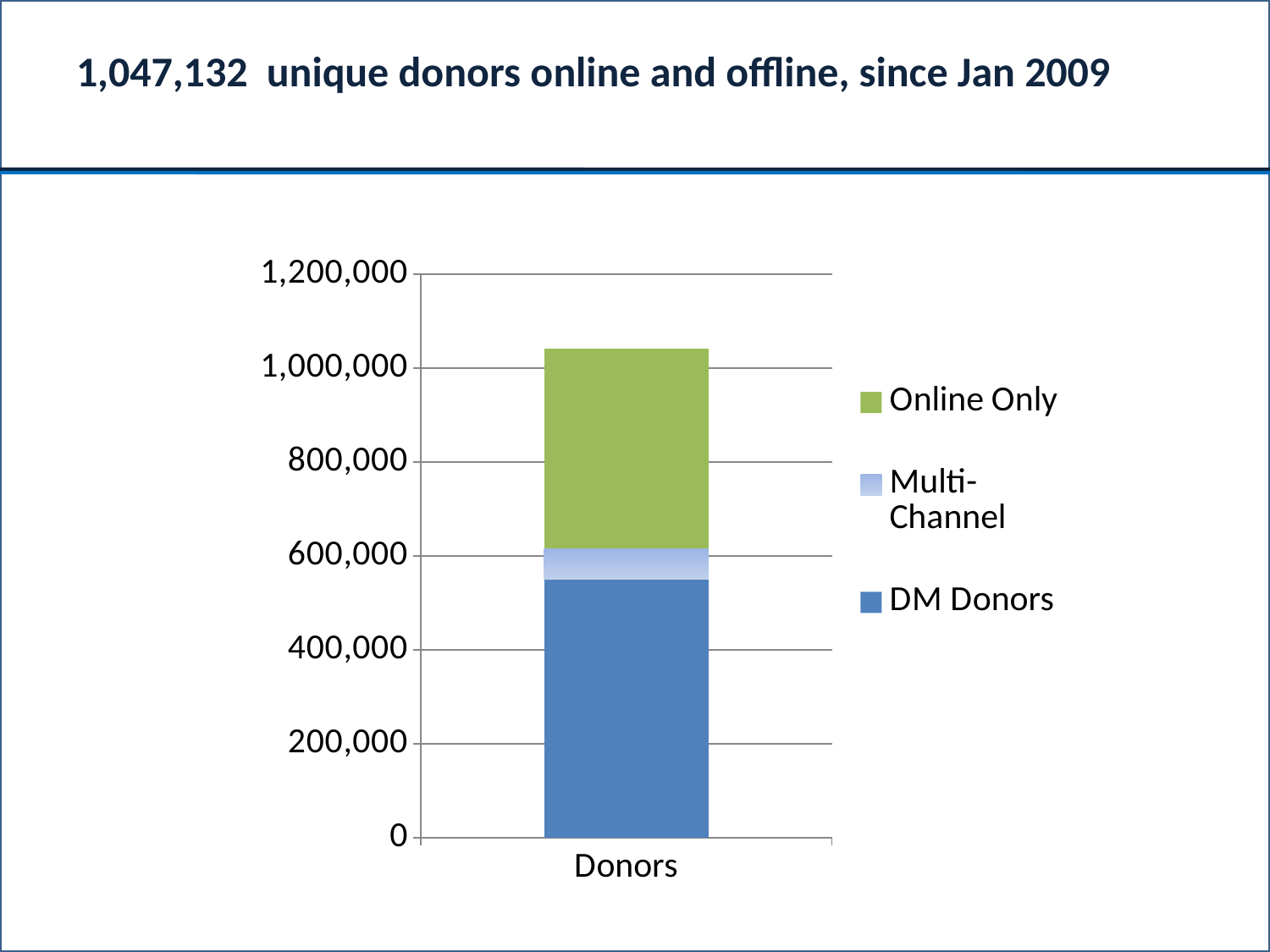
Is the value for DM Donors greater or less than 600,000? less What kind of chart is shown on the slide? Stacked bar chart Is the total height of the Donors bar greater or less than 1,000,000? greater Is the value for Multi-Channel greater or less than 200,000? less Which series forms the largest segment of the Donors bar? DM Donors Which series forms the smallest segment of the Donors bar? Multi-Channel How many categories are shown on the x axis? 1 How many series does the legend list? 3 Which segment is larger in the Donors bar, DM Donors or Online Only? DM Donors What colour represents the Online Only series? Green What is the category label shown on the x axis? Donors